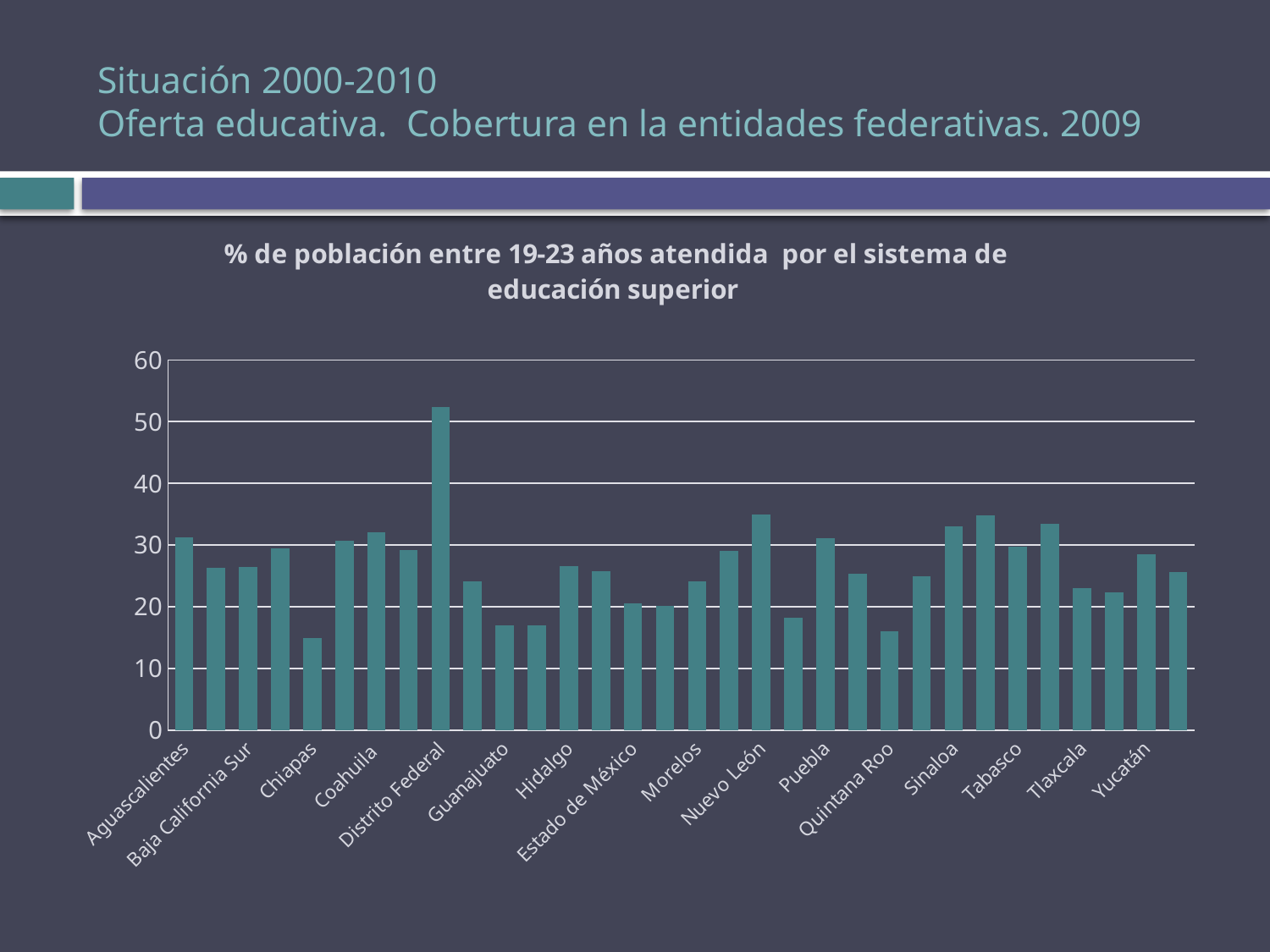
What kind of chart is shown on the slide? bar chart Which entity has the highest value in the chart? Distrito Federal What is the title of the chart? % de población entre 19-23 años atendida por el sistema de educación superior Is the value for Sinaloa greater or less than 30? greater Which is larger, the value for Tabasco or the value for Quintana Roo? Tabasco Is the value for Morelos greater or less than 30? less Which is larger, the value for Distrito Federal or the value for Nuevo León? Distrito Federal Is the value for Distrito Federal greater or less than 50? greater Which is larger, the value for Chiapas or the value for Coahuila? Coahuila